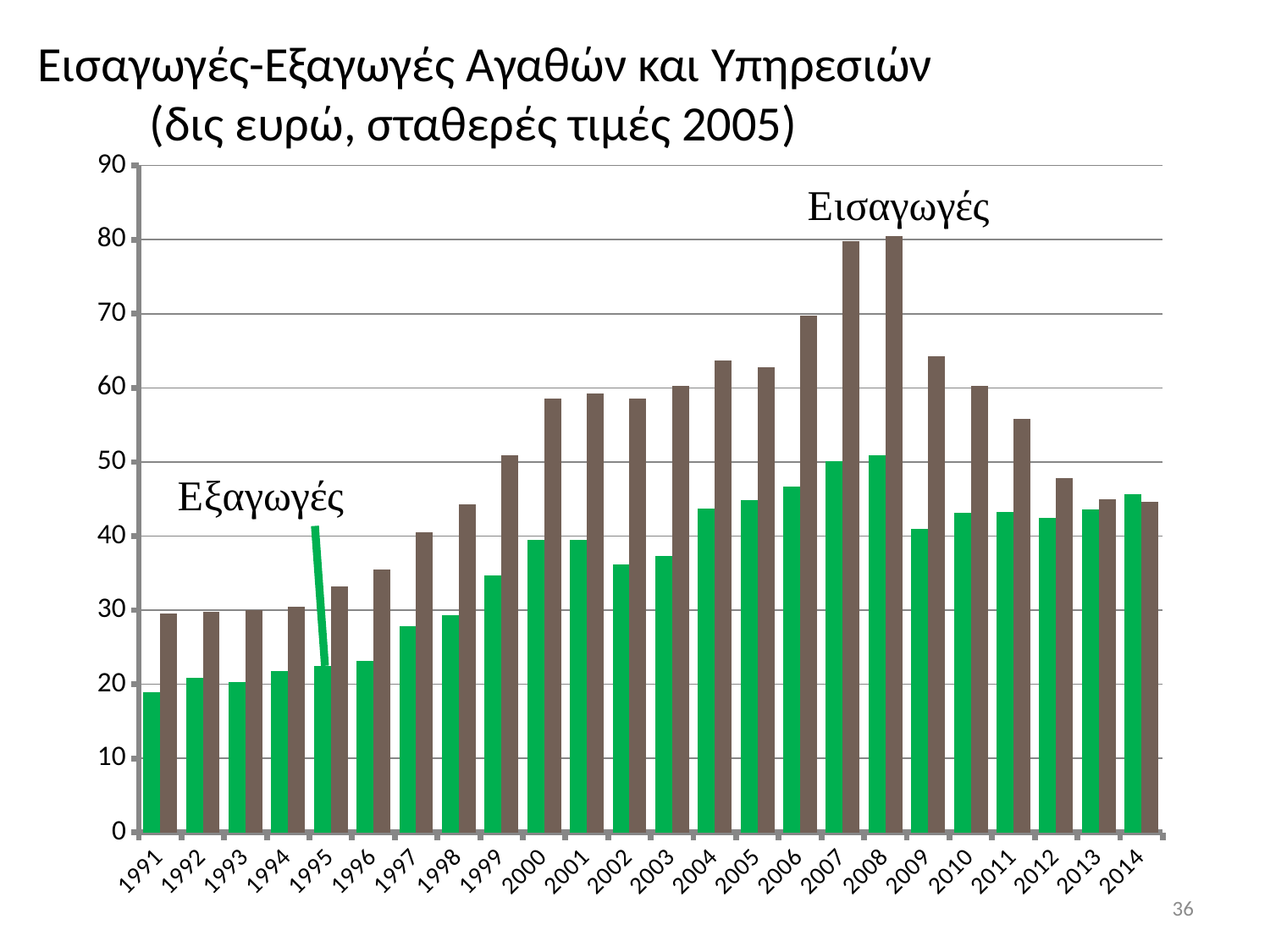
In which year is the Εξαγωγές value lowest? 1991 How many years are shown on the x axis of the chart? 24 Do the Εισαγωγές values rise or fall from 2008 to 2012? fall What colour are the Εξαγωγές bars? green In 2007, which is larger, Εισαγωγές or Εξαγωγές? Εισαγωγές Is the Εισαγωγές value for 2011 greater or less than 60? less Is the Εισαγωγές value for 2004 greater or less than 60? greater Is the Εισαγωγές value for 2012 greater or less than 50? less How many data series does the chart plot? 2 What kind of chart is shown on the slide? bar chart